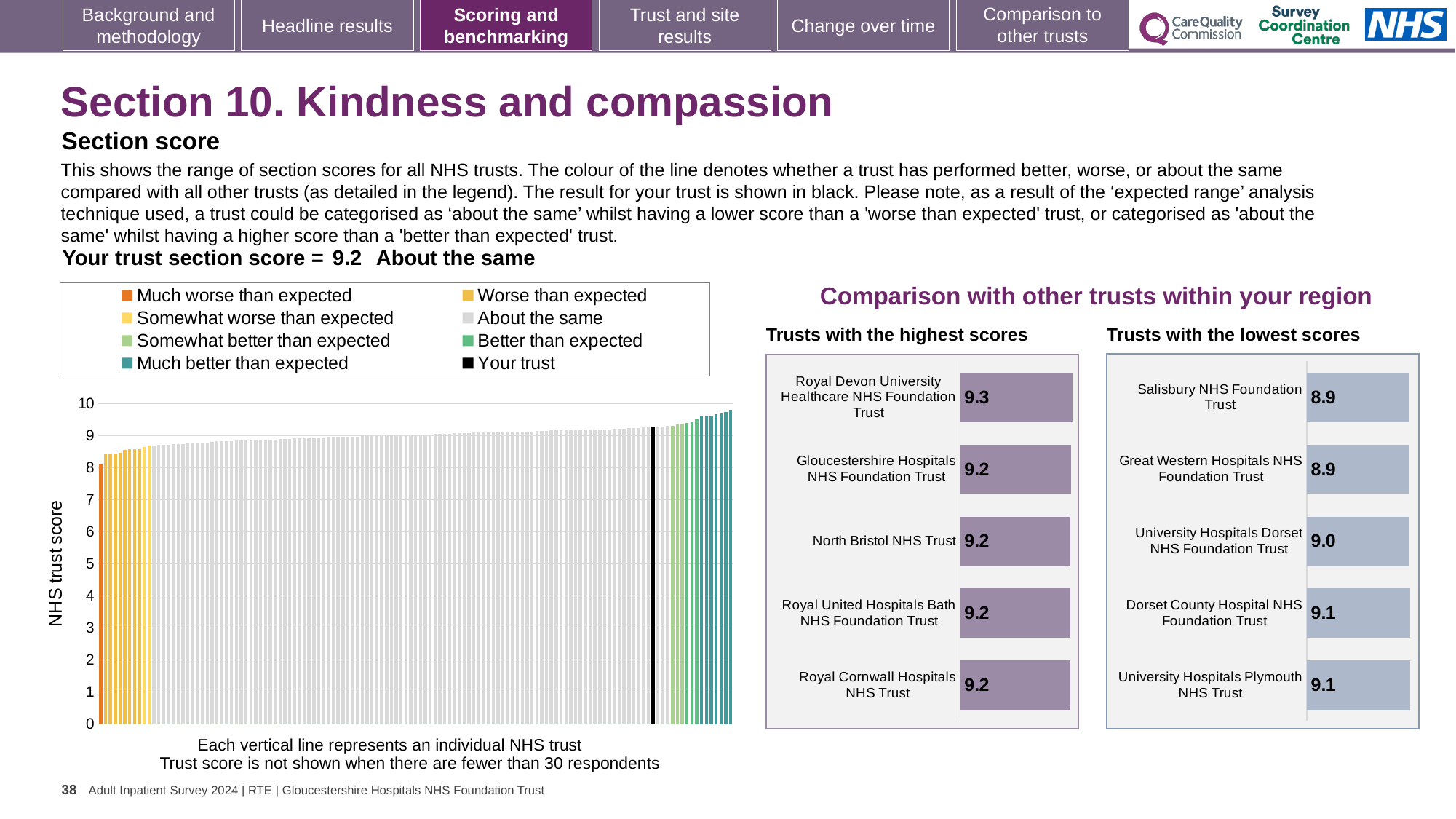
In the large chart on the left, is the value of the lowest (leftmost) bar greater or less than 7? greater In the 'Trusts with the highest scores' chart, which trust has the highest score? Royal Devon University Healthcare NHS Foundation Trust In the 'Trusts with the highest scores' chart, what is the score for Royal Devon University Healthcare NHS Foundation Trust? 9.3 In the large chart on the left, how many entries does the legend list? 8 In the 'Trusts with the lowest scores' chart, which has the larger score: Dorset County Hospital NHS Foundation Trust or Great Western Hospitals NHS Foundation Trust? Dorset County Hospital NHS Foundation Trust In the 'Trusts with the highest scores' chart, how many trusts are listed? 5 In the 'Trusts with the lowest scores' chart, what is the score for University Hospitals Dorset NHS Foundation Trust? 9.0 In the 'Trusts with the lowest scores' chart, what is the difference between the scores of University Hospitals Plymouth NHS Trust and Salisbury NHS Foundation Trust? 0.2 In the large chart on the left, do the trust scores rise or fall from left to right? Rise In the 'Trusts with the highest scores' chart, what is the difference between the scores of Royal Devon University Healthcare NHS Foundation Trust and North Bristol NHS Trust? 0.1 What kind of chart is the large chart on the left showing NHS trust scores? Bar chart In the 'Trusts with the lowest scores' chart, what is the score for Salisbury NHS Foundation Trust? 8.9